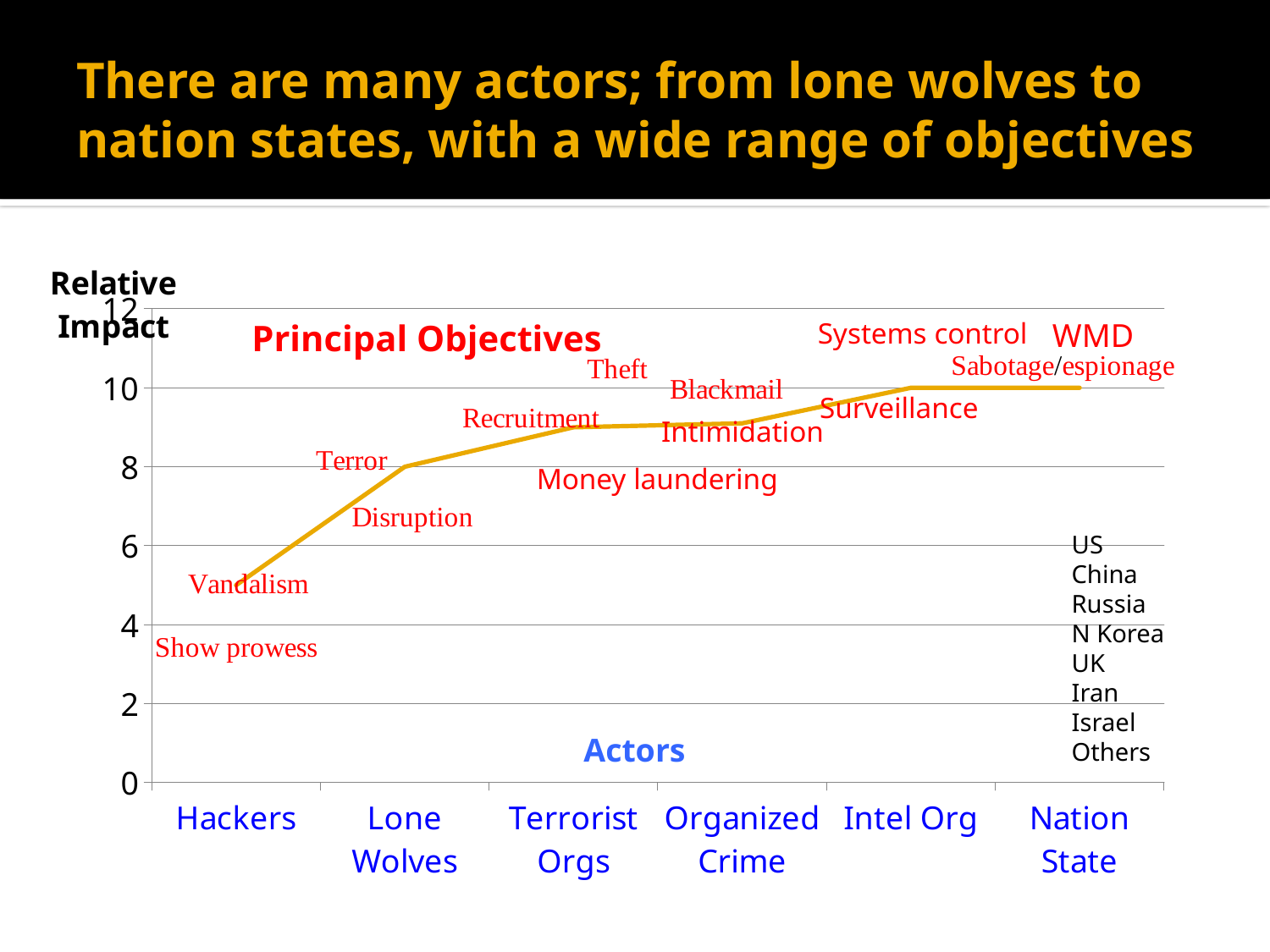
Is the relative impact value for Hackers greater or less than 6? less What is the label on the x axis of the chart? Actors Is the relative impact value for Terrorist Orgs greater or less than 8? greater What is the relative impact value for Nation State? 10 Which actor category has the lowest relative impact? Hackers What is the relative impact value for Lone Wolves? 8 What type of chart is shown on the slide? line chart Which has a higher relative impact, Lone Wolves or Intel Org? Intel Org How many actor categories are plotted along the x axis? 6 What is the difference in relative impact between Intel Org and Lone Wolves? 2 What is the relative impact value for Intel Org? 10 Does the relative impact rise or fall as you move from Hackers to Nation State along the x axis? rises